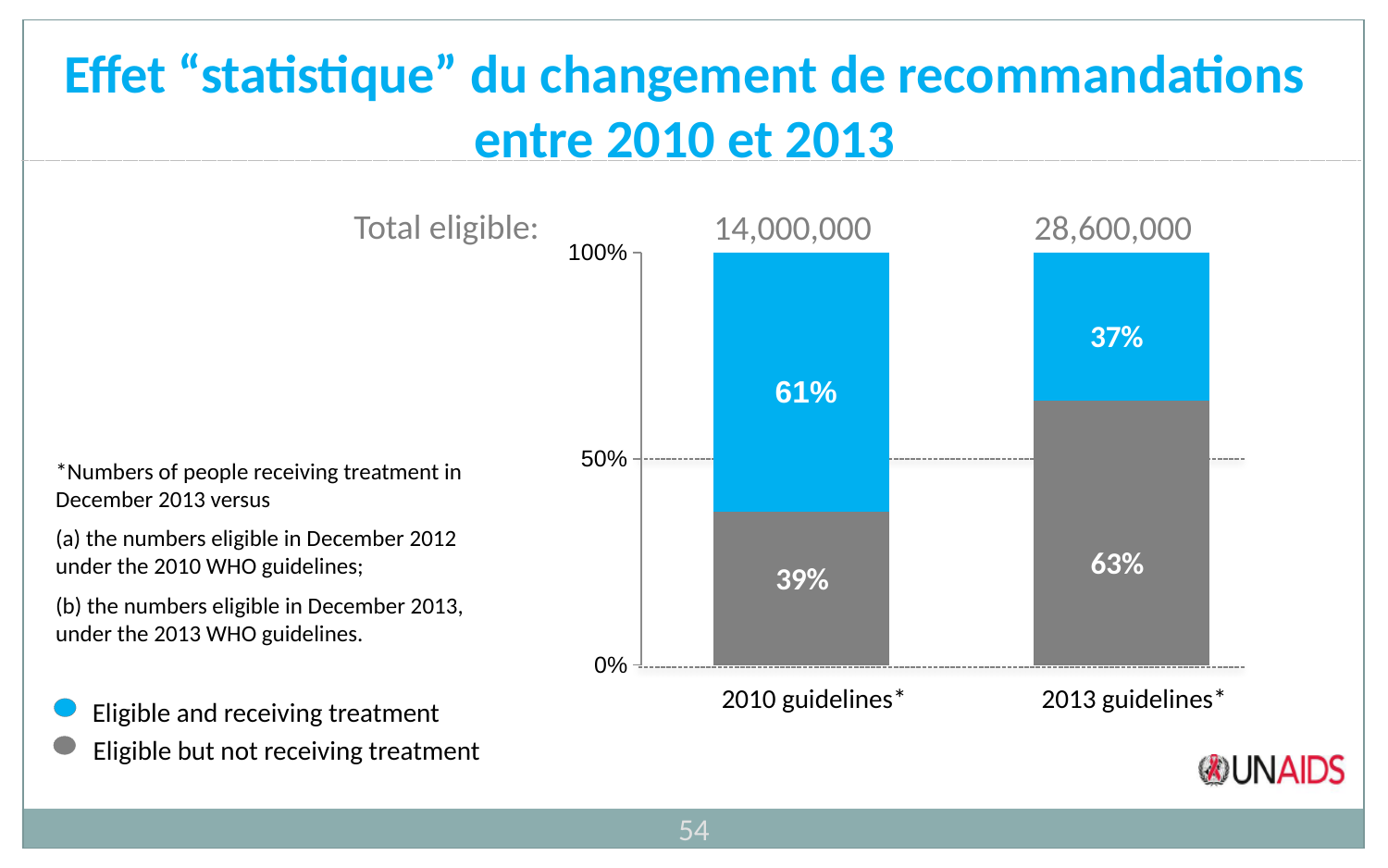
What percentage of people were eligible but not receiving treatment under the 2013 guidelines? 63% What percentage of people were eligible but not receiving treatment under the 2010 guidelines? 39% Which guidelines category has the higher share of people eligible and receiving treatment? 2010 guidelines* What is the total number of eligible people shown above the 2010 guidelines bar? 14,000,000 By how many percentage points does the share eligible and receiving treatment under the 2010 guidelines exceed that under the 2013 guidelines? 24 What percentage of people were eligible and receiving treatment under the 2010 guidelines? 61% What is the total number of eligible people shown above the 2013 guidelines bar? 28,600,000 What type of chart is shown on the slide? stacked bar chart Is the share eligible but not receiving treatment under the 2013 guidelines larger or smaller than under the 2010 guidelines? larger How many categories are shown on the x axis of the chart? 2 What percentage of people were eligible and receiving treatment under the 2013 guidelines? 37% How many series does the legend list? 2